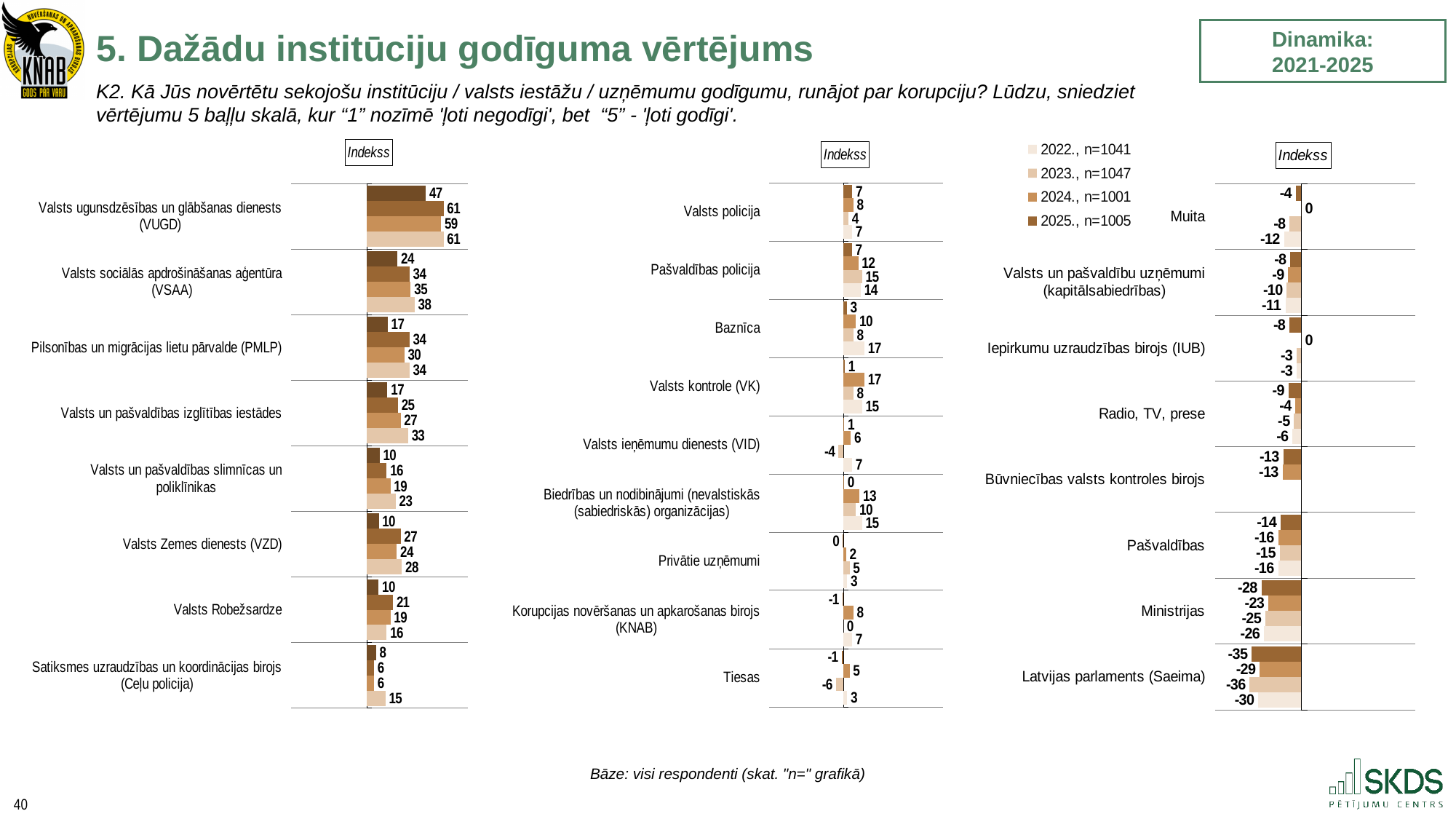
How many series does the legend list? 4 In the middle chart, what is the 2023 index value for Valsts ieņēmumu dienests (VID)? -4 In the right chart, what is the difference between the 2025 values for Ministrijas and Pašvaldības? 14 What kind of chart is used on this slide? Bar chart In the middle chart, which is larger: the 2024 value for Valsts kontrole (VK) or the 2024 value for Baznīca? Valsts kontrole (VK) In the right chart, what is the 2024 index value for Muita? 0 In the left chart, what is the 2022 index value for Satiksmes uzraudzības un koordinācijas birojs (Ceļu policija)? 15 In the left chart, what is the 2025 index value for Valsts ugunsdzēsības un glābšanas dienests (VUGD)? 47 In the middle chart, which institution has the lowest 2023 index value? Tiesas In the left chart, what is the difference between the 2024 and 2025 index values for Valsts sociālās apdrošināšanas aģentūra (VSAA)? 10 In the right chart, what is the 2025 index value for Latvijas parlaments (Saeima)? -35 In the left chart, which institution has the highest 2025 index value? Valsts ugunsdzēsības un glābšanas dienests (VUGD)